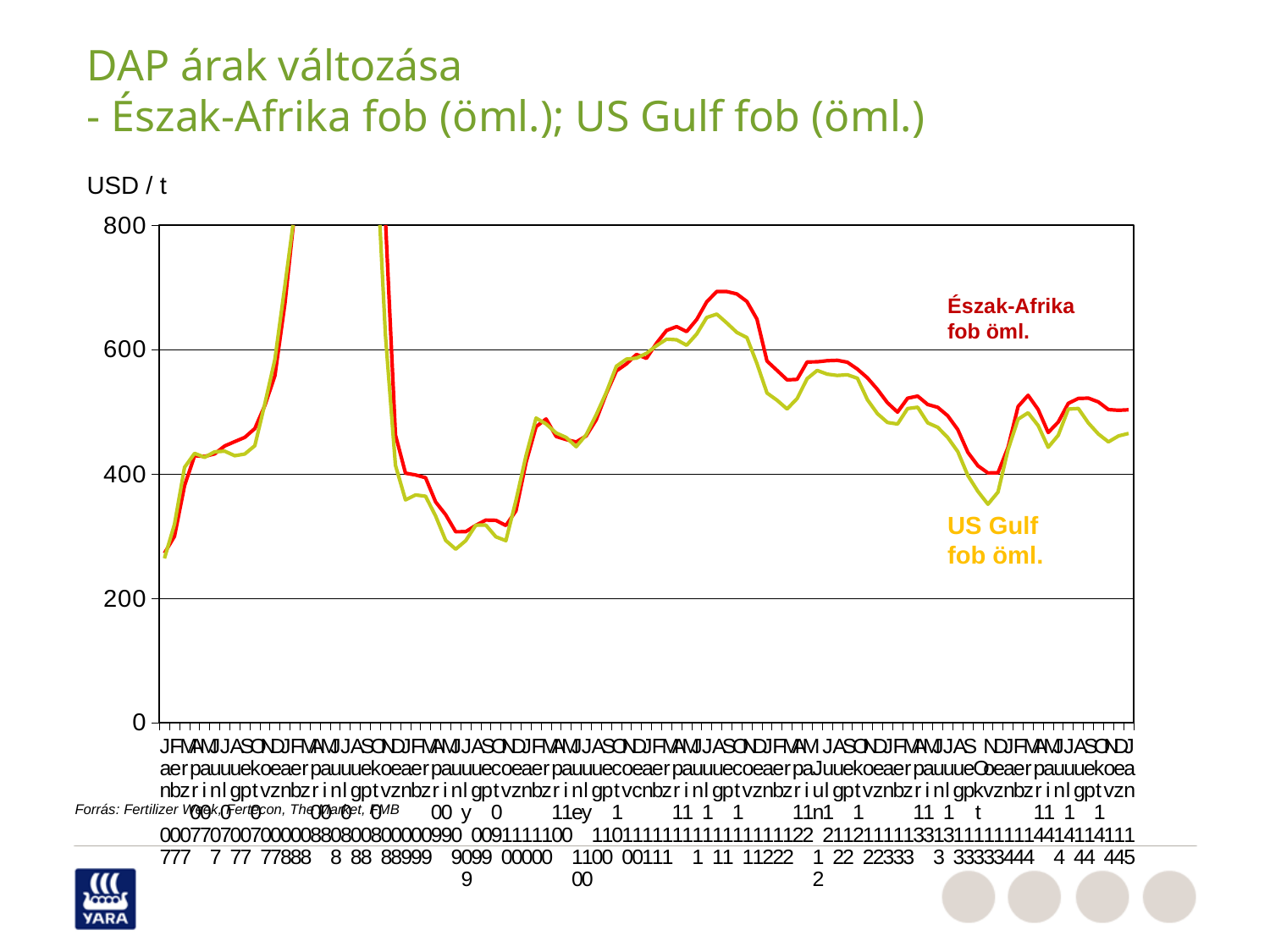
What are the names of the two series plotted on the chart? Észak-Afrika fob öml. and US Gulf fob öml. Which series is drawn in red? Észak-Afrika fob öml. At the 2011 peak, which series is higher: Észak-Afrika fob öml. or US Gulf fob öml.? Észak-Afrika fob öml. Is the final value of the Észak-Afrika fob öml. series at the right end of the chart greater or less than 400? greater What kind of chart is shown on the slide? line chart Does the peak of the Észak-Afrika fob öml. series in 2008 go above or below 800 USD/t? above What is the highest value shown on the vertical axis of the chart? 800 Is the 2011 peak of the Észak-Afrika fob öml. series greater or less than 800? less How many data series are plotted on the chart? 2